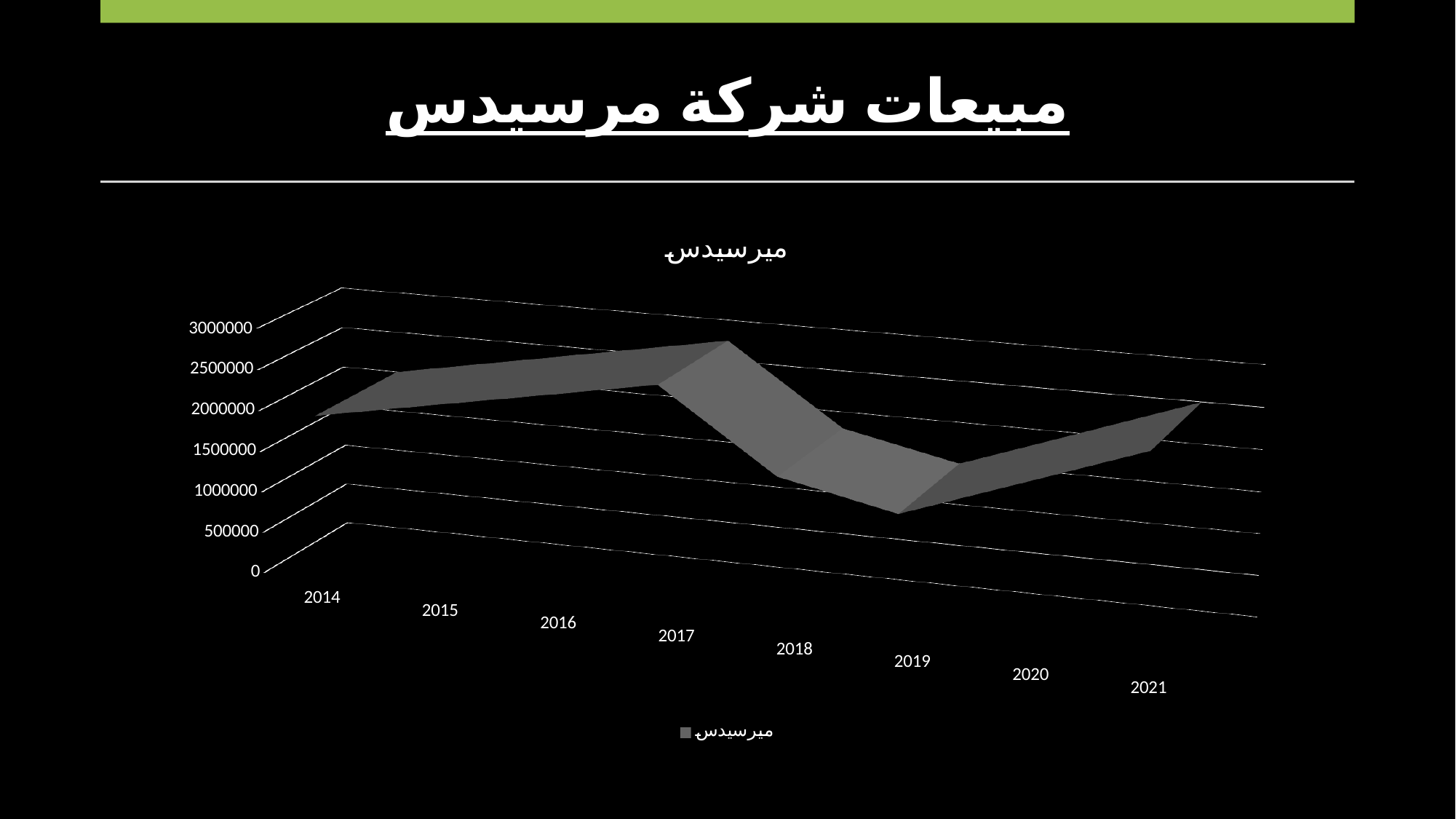
Do the values rise or fall from 2017 to 2019? fall Which year has the larger value, 2017 or 2019? 2017 How many series does the chart's legend list? 1 Which year has the lowest value in the chart? 2019 What is the title of the chart? ميرسيدس Which year has the larger value, 2014 or 2019? 2014 Do the values rise or fall from 2019 to 2021? rise Which year has the larger value, 2019 or 2021? 2021 Which year has the highest value in the chart? 2017 How many years are plotted along the x axis of the chart? 8 What kind of chart is shown on the slide? line chart What is the first year shown on the x axis of the chart? 2014